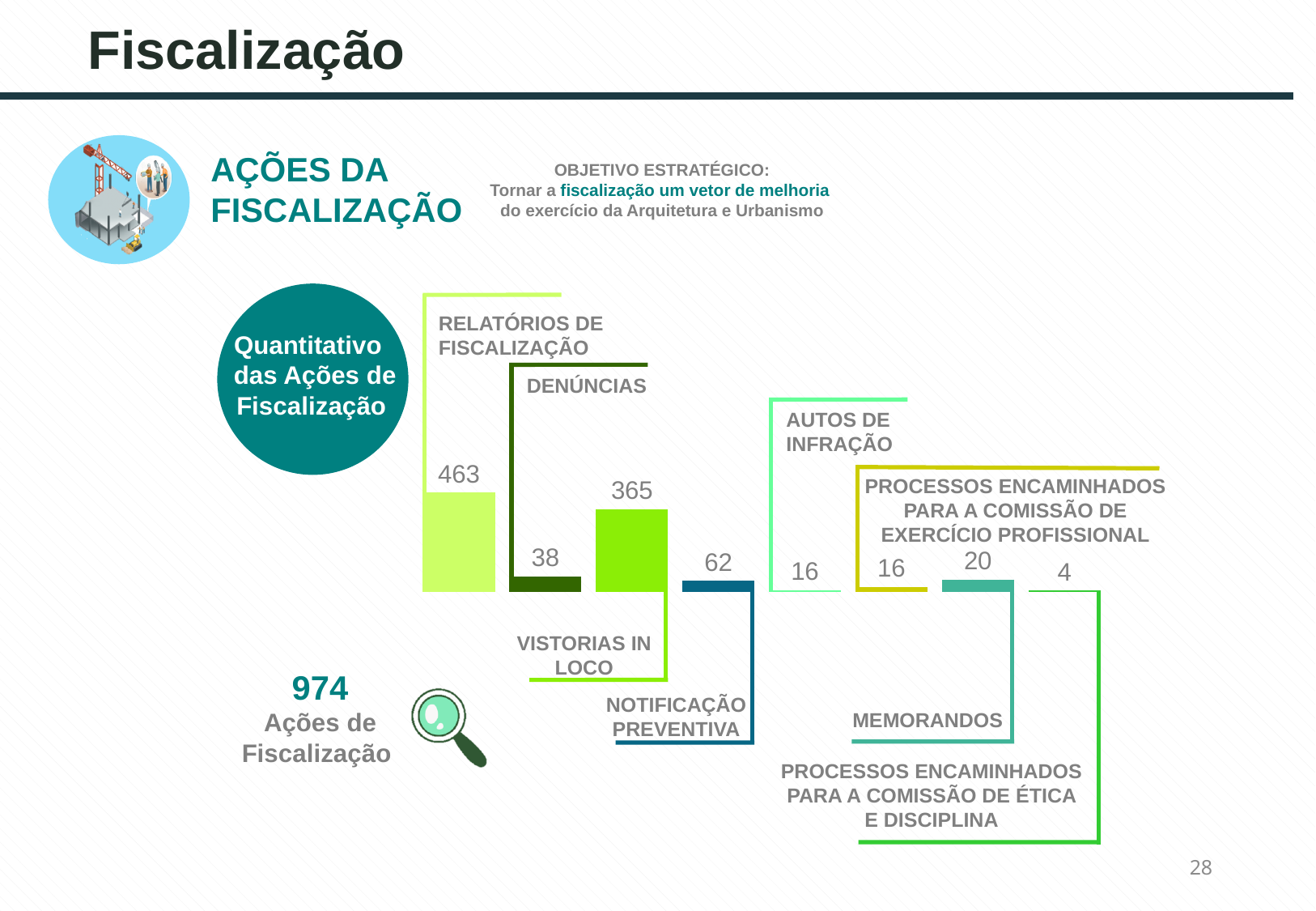
What is the value for Relatórios de Fiscalização? 463 Which category has the lowest value? Processos Encaminhados para a Comissão de Ética e Disciplina What total number of Ações de Fiscalização is shown on the slide? 974 Which category has the highest value? Relatórios de Fiscalização What is the difference between Relatórios de Fiscalização and Vistorias in Loco? 98 What kind of chart is shown on the slide? bar chart What is the value for Processos Encaminhados para a Comissão de Ética e Disciplina? 4 What is the value for Notificação Preventiva? 62 How many categories are shown in the chart? 8 What is the value for Memorandos? 20 What is the value for Vistorias in Loco? 365 Which is larger, Denúncias or Notificação Preventiva? Notificação Preventiva